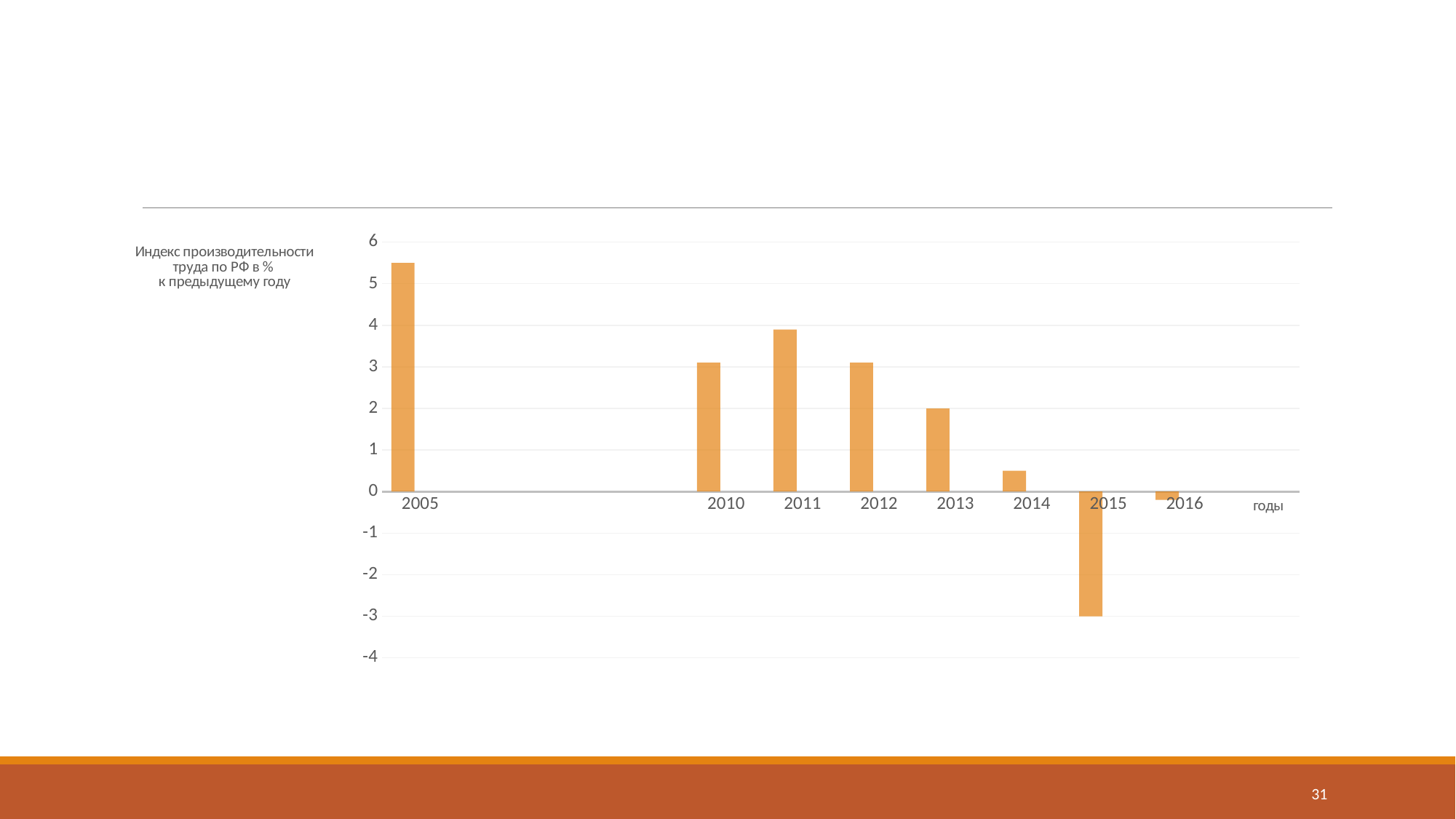
Which year has the highest value in the chart? 2005 How many years are shown on the x axis of the chart? 8 Is the value for 2014 greater or less than 1? less What label is shown at the right end of the x axis? годы Which year has the lowest value in the chart? 2015 Is the value for 2005 greater or less than 5? greater What kind of chart is shown on the slide? bar chart Is the value for 2011 greater or less than 4? less Which is larger, the value for 2005 or the value for 2011? 2005 Do the values generally rise or fall from 2011 to 2015? fall Which is larger, the value for 2013 or the value for 2014? 2013